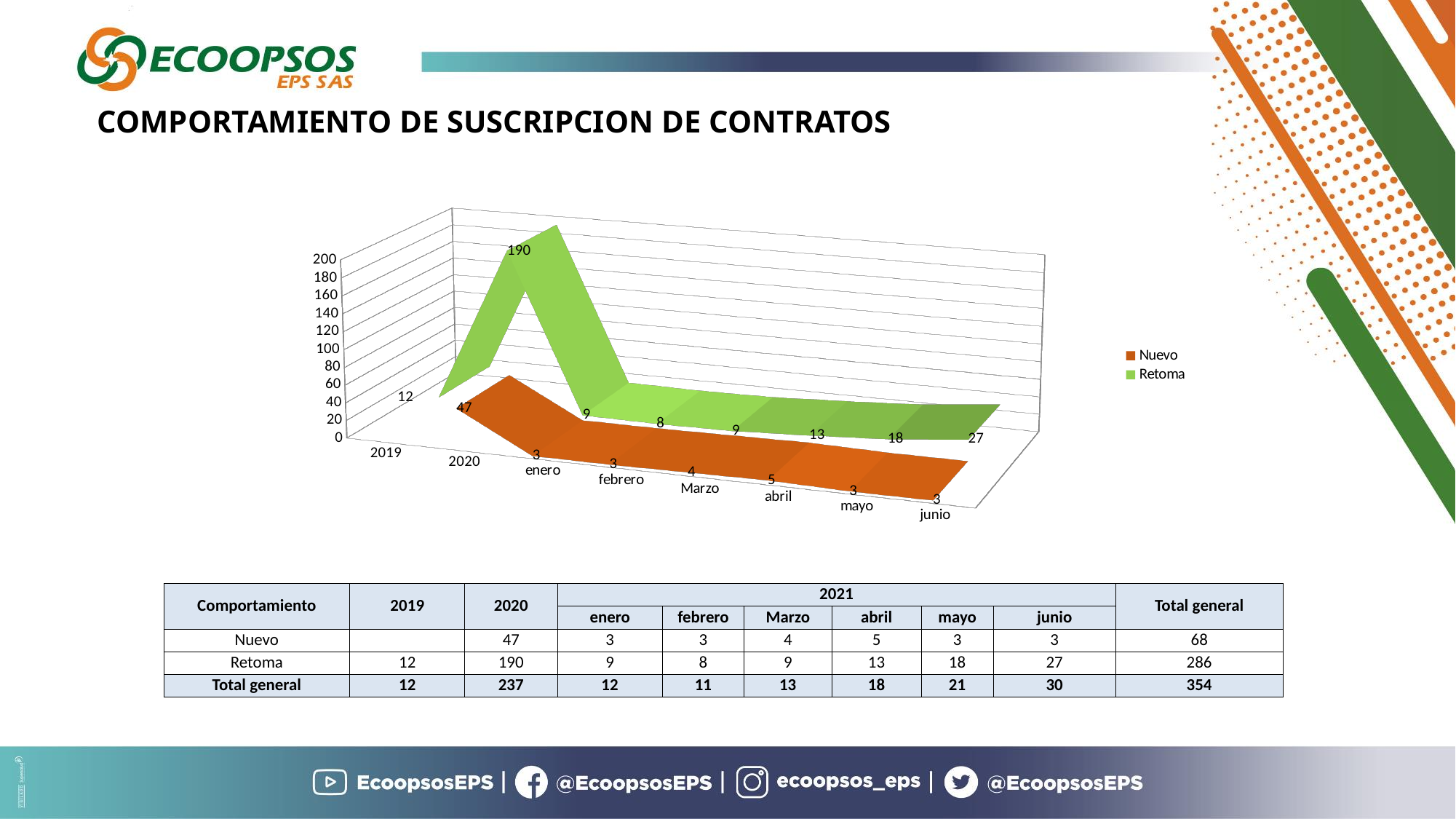
What kind of chart is shown on the slide? 3D line chart How many series does the chart legend list? 2 What is the difference between the Retoma value and the Nuevo value in 2020? 143 How many categories are shown along the x axis of the chart? 8 What is the value for Retoma in junio? 27 What is the value for Nuevo in 2020? 47 What is the value for Nuevo in abril? 5 Does the Retoma series rise or fall from Marzo to junio? Rise What is the value for Retoma in 2020? 190 In which category does the Retoma series reach its highest value? 2020 Which is larger in mayo, the Nuevo value or the Retoma value? Retoma In which category does the Retoma series have its lowest value? febrero